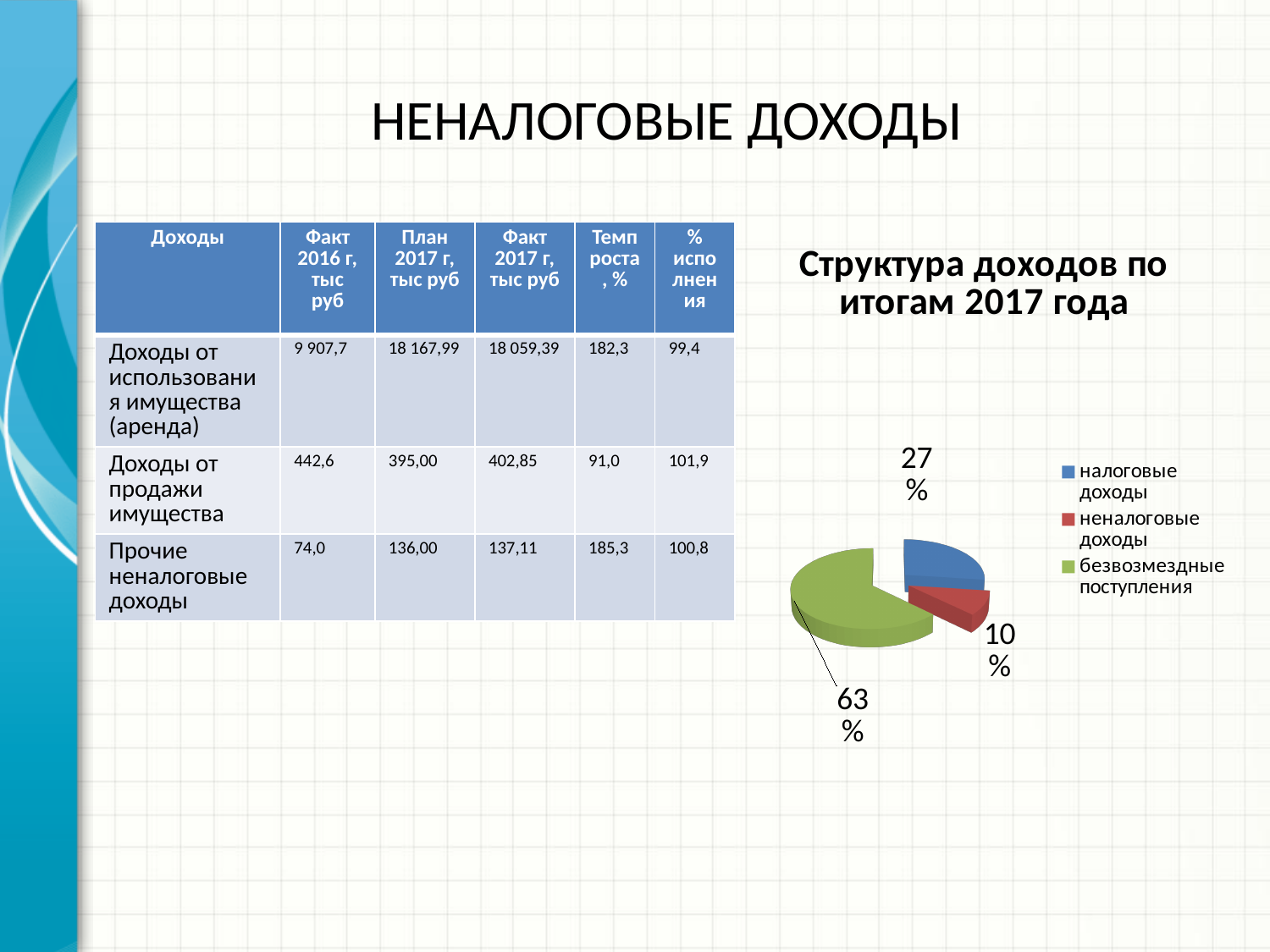
What kind of chart is shown on the slide? pie chart What share of the pie does налоговые доходы have? 27% How many slices does the pie chart have? 3 What is the title of the pie chart? Структура доходов по итогам 2017 года What is the difference in percentage points between безвозмездные поступления and налоговые доходы? 36 What share of the pie does безвозмездные поступления have? 63% What share of the pie does неналоговые доходы have? 10% What colour is the slice for безвозмездные поступления? green Which category has the largest slice of the pie? безвозмездные поступления How many entries does the legend of the pie chart list? 3 Which category has the smallest slice of the pie? неналоговые доходы Which is larger: the slice for налоговые доходы or the slice for неналоговые доходы? налоговые доходы